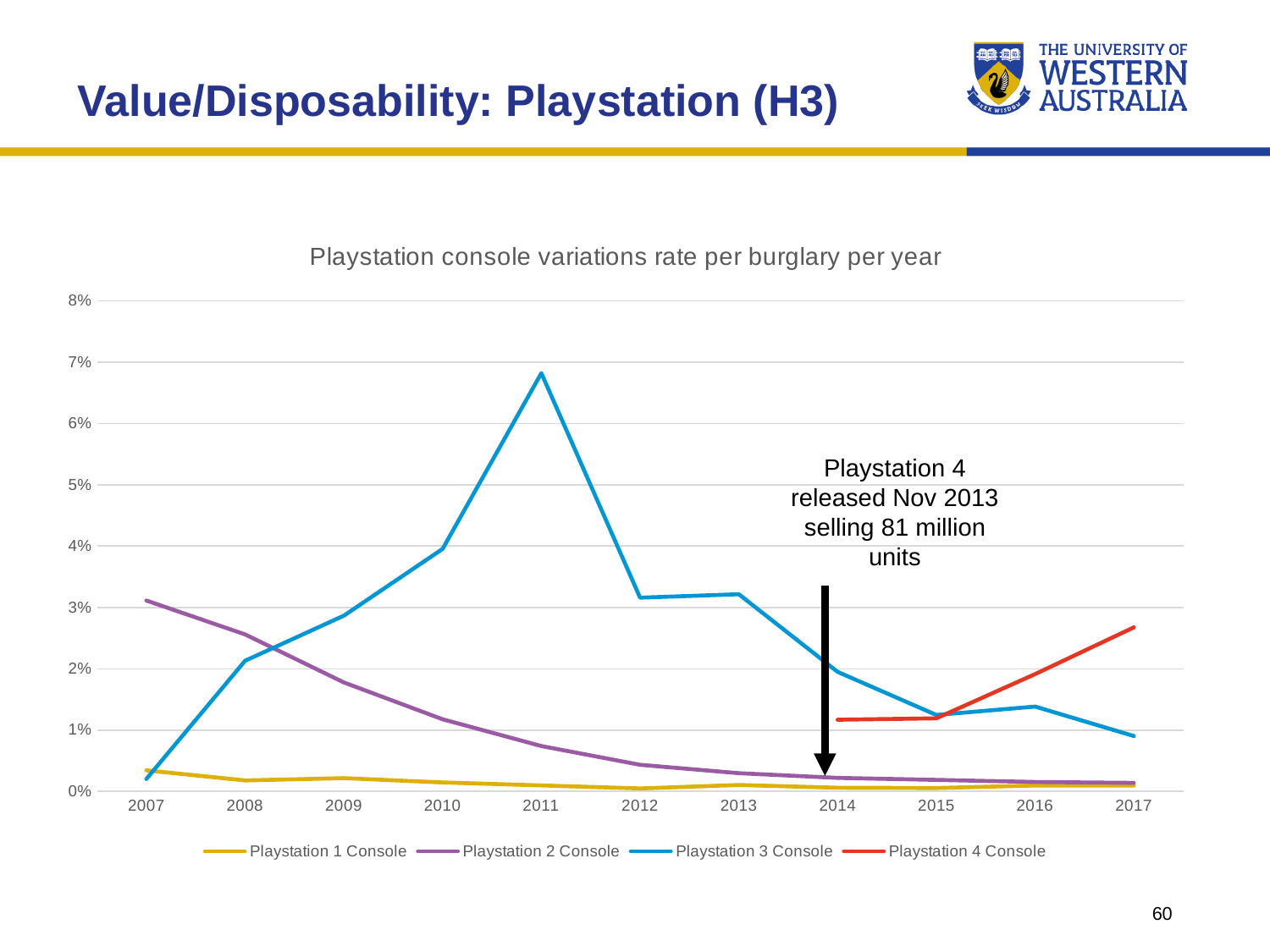
Which series has the highest value in 2007? Playstation 2 Console How many years are shown on the x axis? 11 Does the Playstation 4 Console line rise or fall from 2014 to 2017? Rise Is the value for Playstation 2 Console in 2007 greater or less than 2%? greater In 2017, which is higher: Playstation 3 Console or Playstation 4 Console? Playstation 4 Console Does the Playstation 2 Console line rise or fall from 2007 to 2017? Fall How many series does the legend list? 4 What kind of chart is shown on the slide? Line chart Is the value for Playstation 3 Console in 2010 greater or less than 3%? greater What is the title of the chart? Playstation console variations rate per burglary per year In which year does the Playstation 3 Console line reach its highest value? 2011 Is the value for Playstation 3 Console in 2011 greater or less than 6%? greater